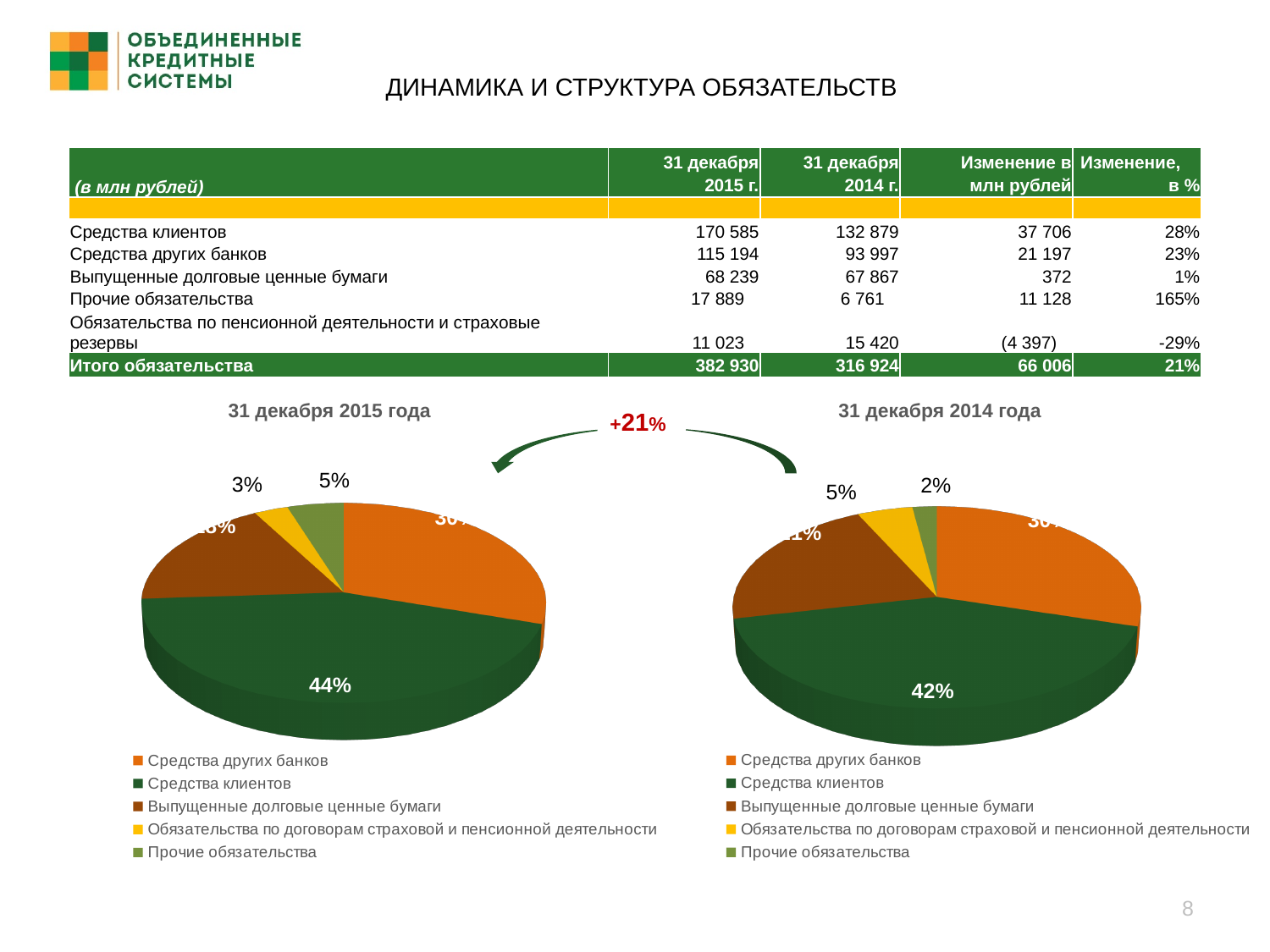
In the chart titled "31 декабря 2014 года", what share is shown for Средства клиентов? 42% In the chart titled "31 декабря 2015 года", what share is shown for Обязательства по договорам страховой и пенсионной деятельности? 3% In the chart titled "31 декабря 2014 года", which category has the smallest slice? Прочие обязательства In the chart titled "31 декабря 2014 года", what share is shown for Прочие обязательства? 2% How many entries does the legend of the chart titled "31 декабря 2014 года" list? 5 In the chart titled "31 декабря 2014 года", what share is shown for Обязательства по договорам страховой и пенсионной деятельности? 5% In the chart titled "31 декабря 2015 года", what share is shown for Прочие обязательства? 5% What is the difference between the share of Средства клиентов in the chart titled "31 декабря 2015 года" and in the chart titled "31 декабря 2014 года"? 2 percentage points In the chart titled "31 декабря 2015 года", which category has the largest slice? Средства клиентов In the chart titled "31 декабря 2015 года", what share is shown for Средства клиентов? 44% What kind of chart is the chart titled "31 декабря 2015 года"? Pie chart Is the share of Средства клиентов larger in the chart titled "31 декабря 2015 года" or in the chart titled "31 декабря 2014 года"? 31 декабря 2015 года